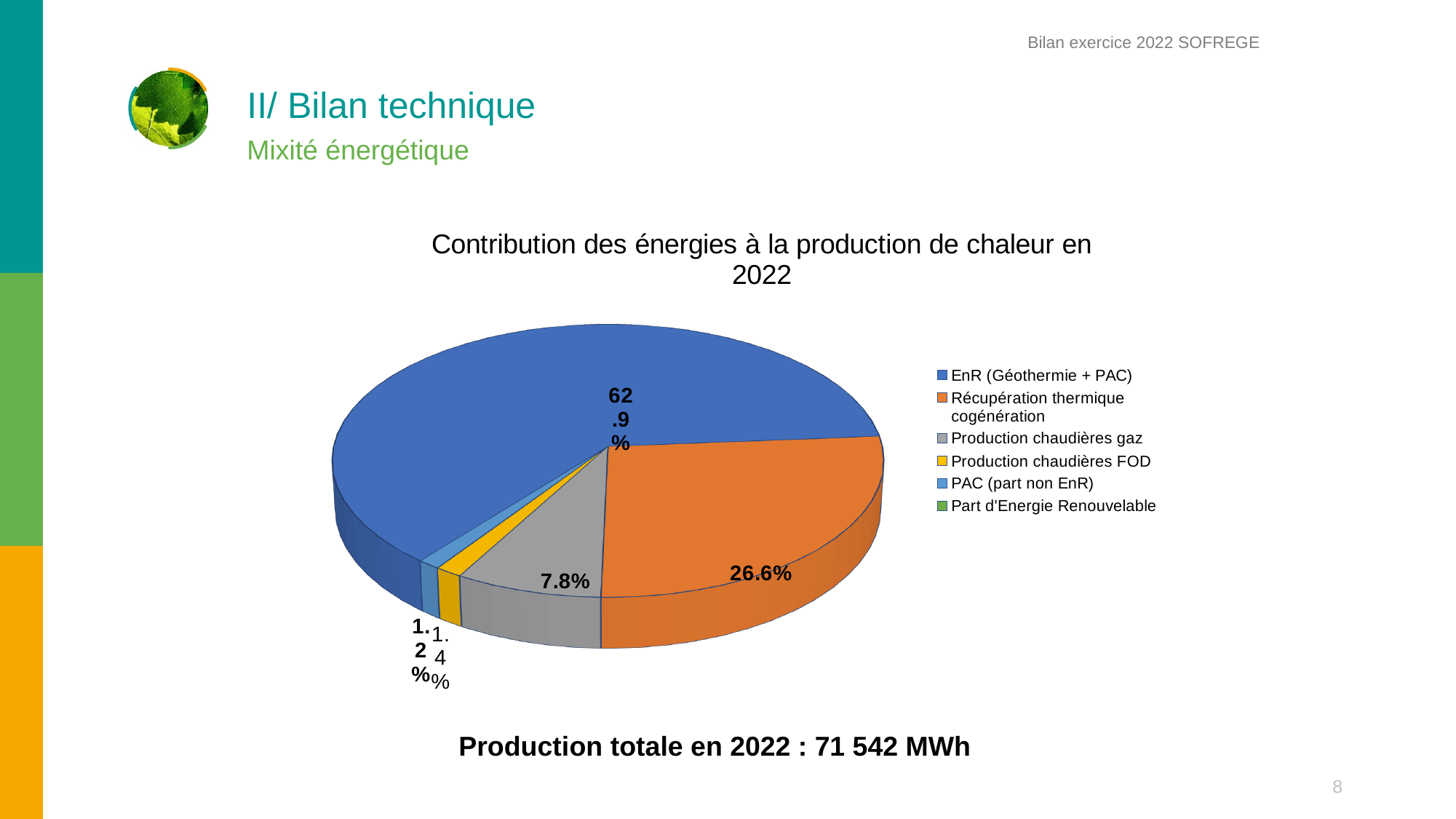
How many entries does the legend list? 6 What is the difference between the shares of Récupération thermique cogénération and Production chaudières gaz? 18.8 percentage points What total production for 2022 is stated below the chart? 71 542 MWh Which energy source has the largest slice of the pie? EnR (Géothermie + PAC) What is the share for Production chaudières gaz? 7.8% What kind of chart is shown on the slide? Pie chart What share of heat production does EnR (Géothermie + PAC) account for? 62.9% What is the combined share of EnR (Géothermie + PAC) and Récupération thermique cogénération? 89.5% What is the title of the chart? Contribution des énergies à la production de chaleur en 2022 By how many percentage points does EnR (Géothermie + PAC) exceed Récupération thermique cogénération? 36.3 percentage points Which is larger: Récupération thermique cogénération or Production chaudières gaz? Récupération thermique cogénération What is the share for Récupération thermique cogénération? 26.6%